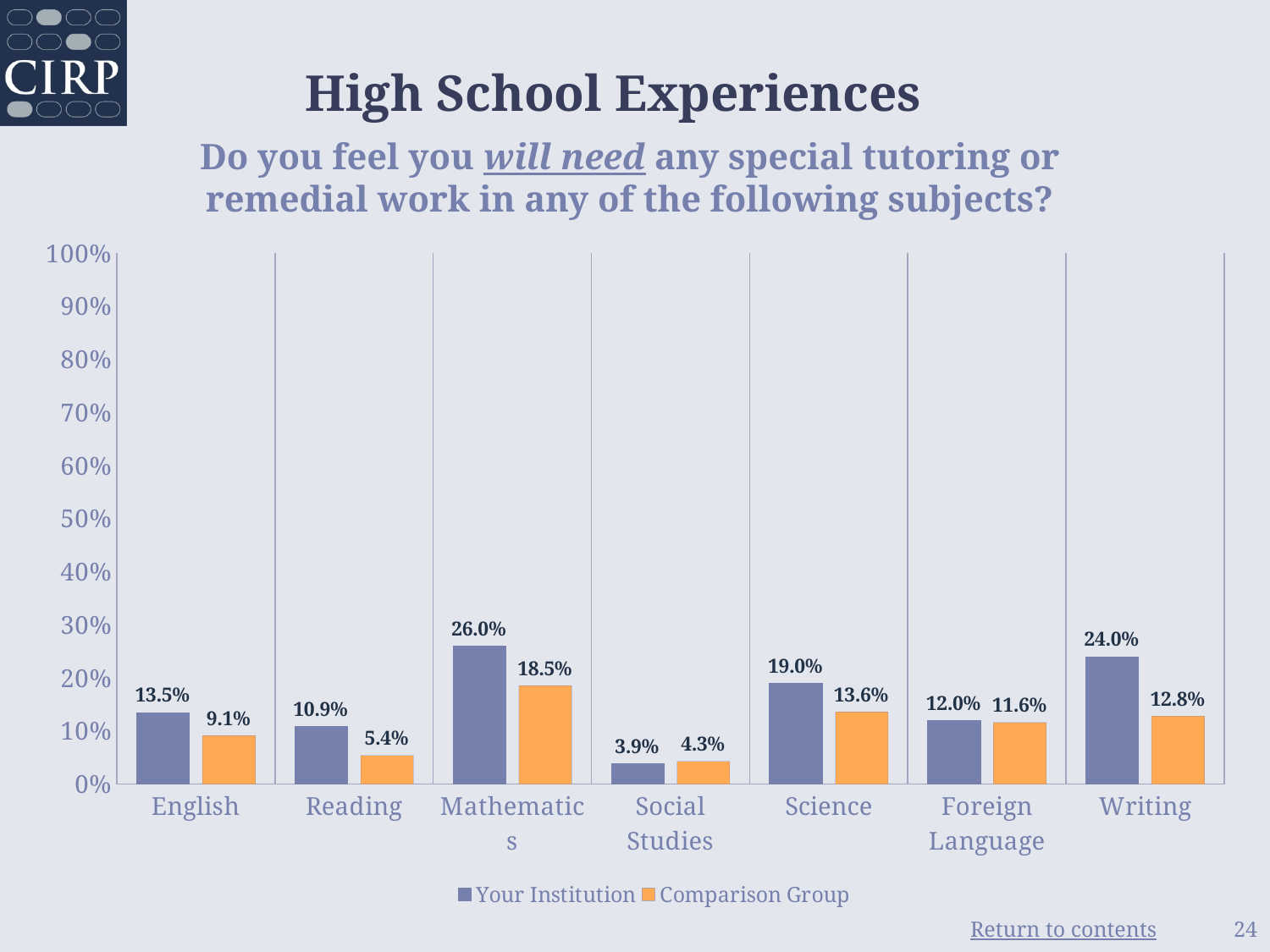
Which subject has the highest value for Your Institution? Mathematics What is the value for the Comparison Group in Reading? 5.4% How many series does the legend list? 2 How many subjects are shown on the x axis? 7 What is the value for Your Institution in Foreign Language? 12.0% What kind of chart is shown on the slide? Bar chart Which is larger in Social Studies: Your Institution or the Comparison Group? Comparison Group What is the value for Your Institution in Mathematics? 26.0% Is the value for Your Institution in Science greater or less than 10%? greater What is the difference between Your Institution and the Comparison Group in Writing? 11.2% What colour are the Comparison Group bars? Orange Which subject has the lowest value for the Comparison Group? Social Studies